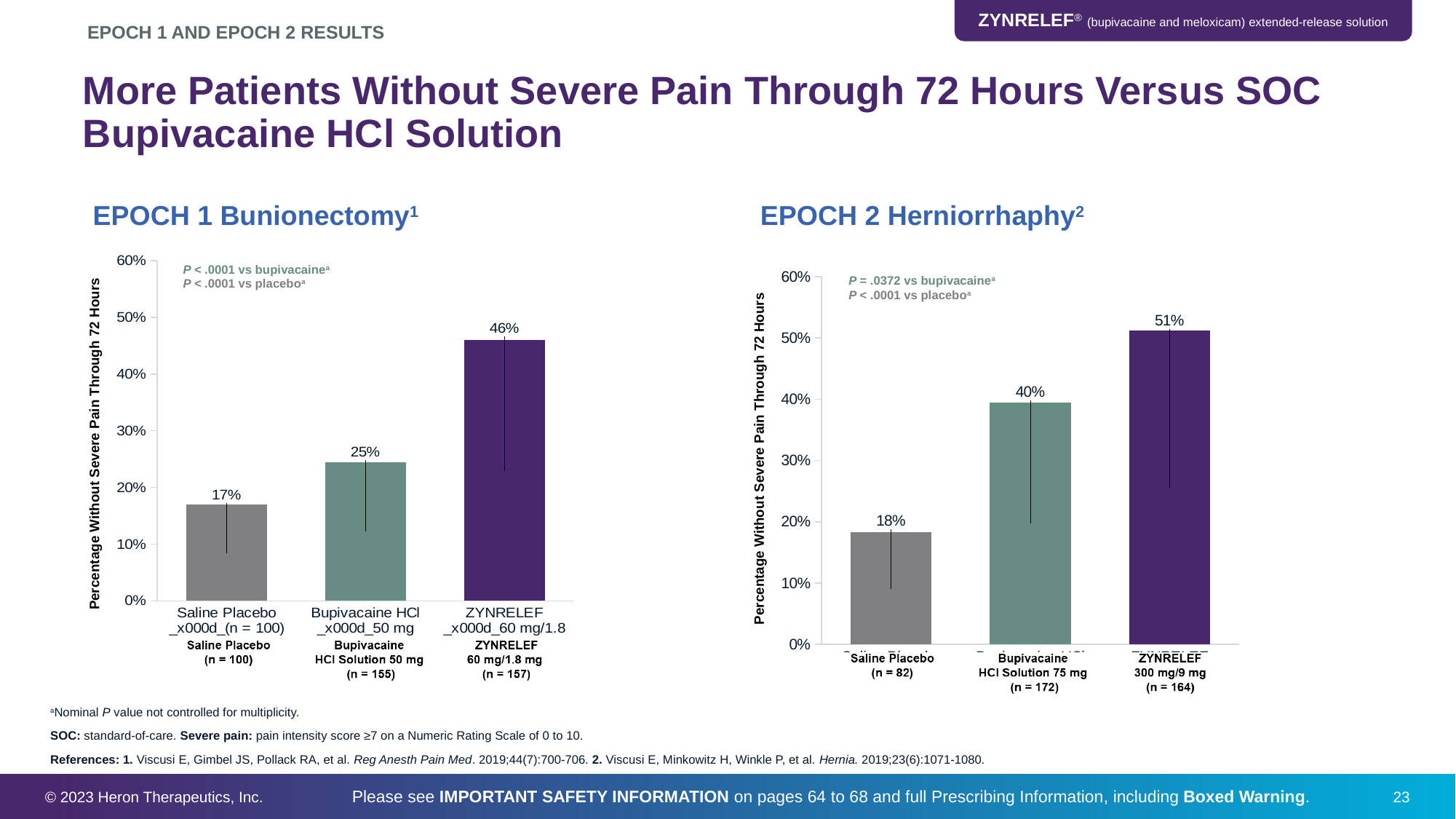
In the EPOCH 1 Bunionectomy chart, which category has the highest value? ZYNRELEF 60 mg/1.8 mg In the EPOCH 1 Bunionectomy chart, what is the value for ZYNRELEF 60 mg/1.8 mg? 46% How many bars are in the EPOCH 1 Bunionectomy chart? 3 In the EPOCH 1 Bunionectomy chart, what is the difference between the ZYNRELEF value and the Bupivacaine HCl Solution 50 mg value? 21% In the EPOCH 1 Bunionectomy chart, what is the value for Saline Placebo? 17% In the EPOCH 2 Herniorrhaphy chart, what is the value for ZYNRELEF 300 mg/9 mg? 51% In the EPOCH 2 Herniorrhaphy chart, what is the difference between the ZYNRELEF value and the Saline Placebo value? 33% In the EPOCH 1 Bunionectomy chart, do the values rise or fall from left to right? Rise In the EPOCH 2 Herniorrhaphy chart, what is the value for Bupivacaine HCl Solution 75 mg? 40% In the EPOCH 2 Herniorrhaphy chart, which is larger, the value for Bupivacaine HCl Solution 75 mg or the value for Saline Placebo? Bupivacaine HCl Solution 75 mg In the EPOCH 2 Herniorrhaphy chart, which category has the lowest value? Saline Placebo What kind of chart is the EPOCH 2 Herniorrhaphy chart? Bar chart